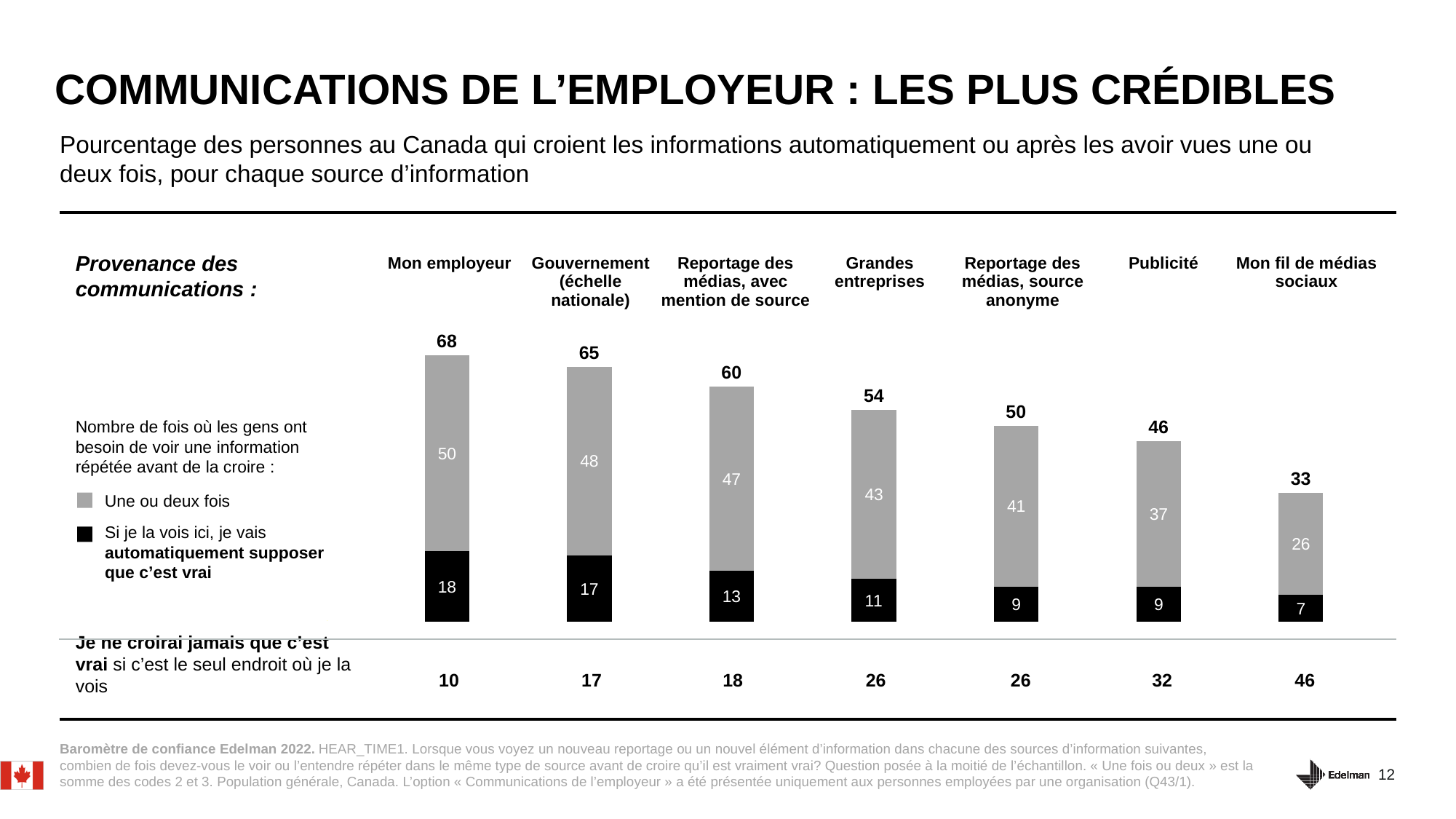
Which information source has the highest total in the chart? Mon employeur Which has a larger "Une ou deux fois" value: "Grandes entreprises" or "Publicité"? Grandes entreprises How many series does the chart's legend list? 2 What is the "Une ou deux fois" value for "Gouvernement (échelle nationale)"? 48 What is the "Si je la vois ici, je vais automatiquement supposer que c'est vrai" value for "Reportage des médias, avec mention de source"? 13 Do the bar totals rise or fall moving from left to right across the chart? fall Which information source has the lowest total in the chart? Mon fil de médias sociaux What is the total value of the stacked bar for "Mon employeur"? 68 How many information sources (categories) are plotted in the chart? 7 What colour represents the "Une ou deux fois" series in the chart? grey What kind of chart is shown on the slide? stacked bar chart What is the difference between the totals for "Mon employeur" and "Mon fil de médias sociaux"? 35